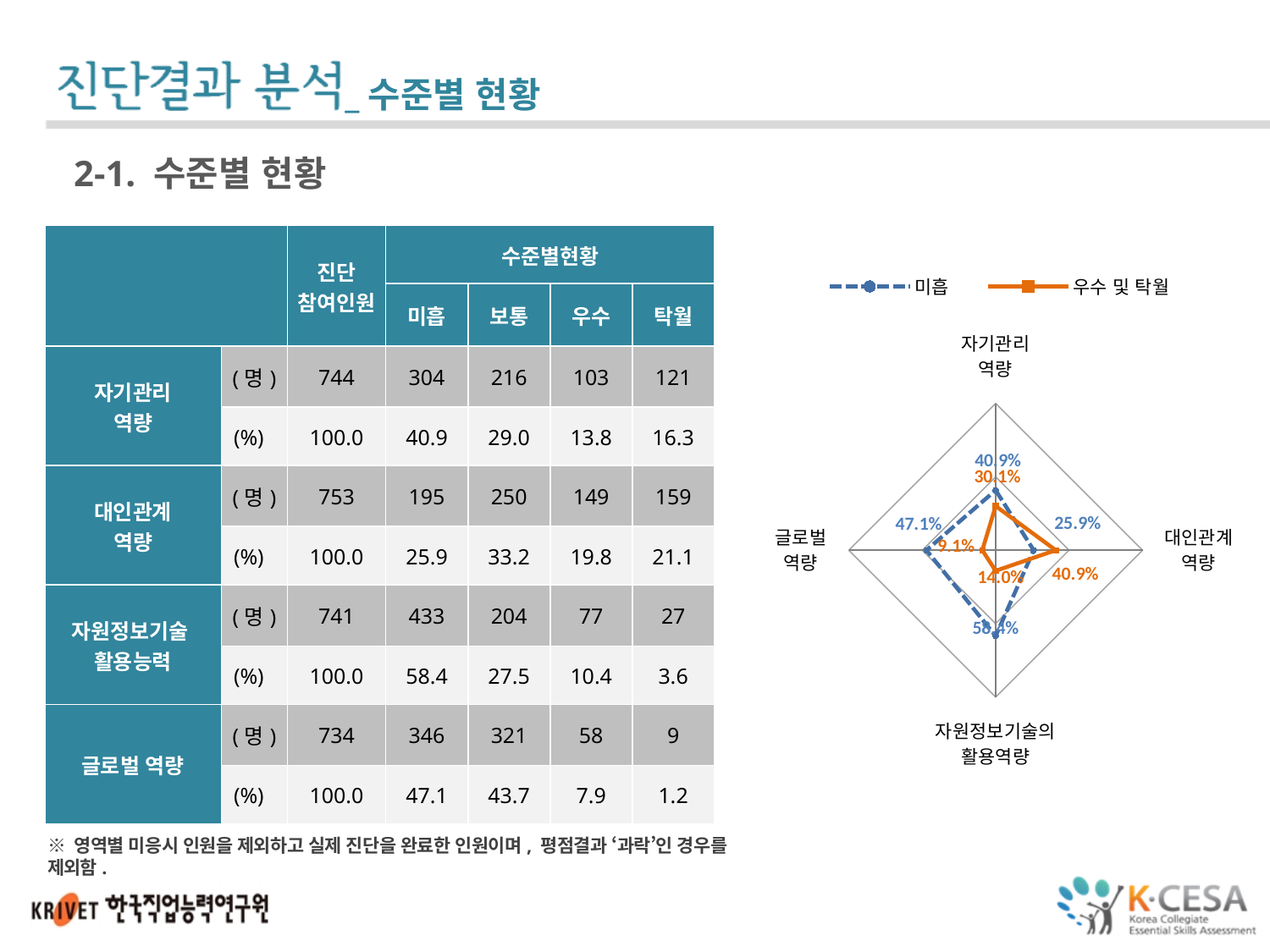
What is the 미흡 value for 자기관리 역량 in the radar chart? 40.9% What is the 우수 및 탁월 value for 글로벌 역량 in the radar chart? 9.1% Which category has the highest 미흡 value in the radar chart? 자원정보기술의 활용역량 How many categories (axes) does the radar chart have? 4 What kind of chart is shown on the slide? Radar chart Which series in the radar chart is drawn with a dashed line? 미흡 What is the 우수 및 탁월 value for 대인관계 역량 in the radar chart? 40.9% What is the 미흡 value for 자원정보기술의 활용역량 in the radar chart? 58.4% In the radar chart, which series has the larger value for 대인관계 역량, 미흡 or 우수 및 탁월? 우수 및 탁월 How many series does the chart legend list? 2 In the radar chart, what is the difference between the 미흡 and 우수 및 탁월 values for 자원정보기술의 활용역량? 44.4% Which category has the lowest 우수 및 탁월 value in the radar chart? 글로벌 역량